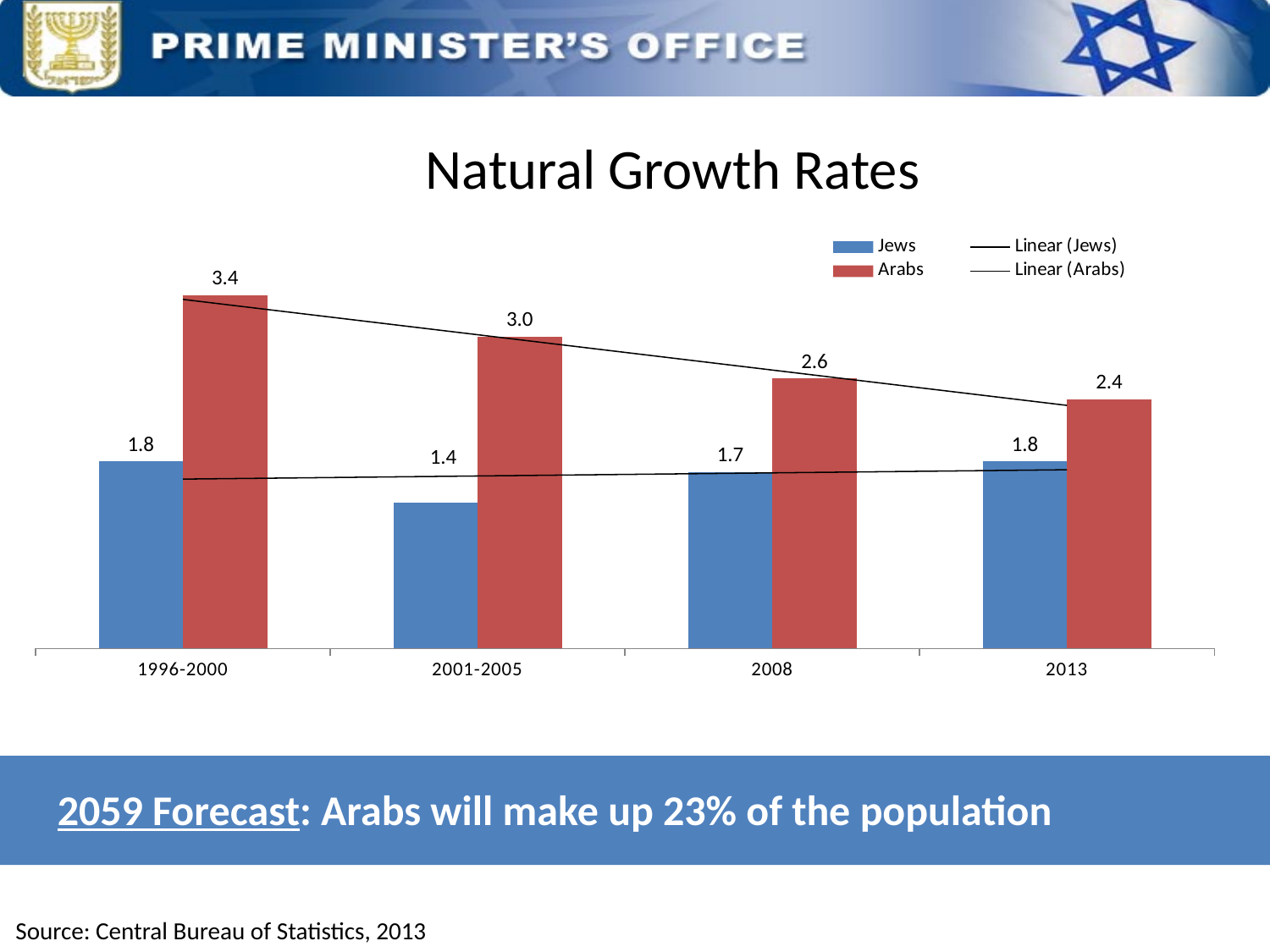
Which is larger in 2013, the Jews rate or the Arabs rate? Arabs In which period is the Jews natural growth rate lowest? 2001-2005 What is the difference between the Arabs and Jews natural growth rates in 2001-2005? 1.6 What is the natural growth rate for Jews in 2001-2005? 1.4 How many time periods are shown on the x axis? 4 Do the Arabs natural growth rates rise or fall from 1996-2000 to 2013? Fall In which period is the Arabs natural growth rate highest? 1996-2000 How many bar series does the legend list? 2 What kind of chart is shown on the slide? Bar chart What is the natural growth rate for Arabs in 2013? 2.4 What is the natural growth rate for Arabs in 1996-2000? 3.4 What is the natural growth rate for Jews in 2008? 1.7